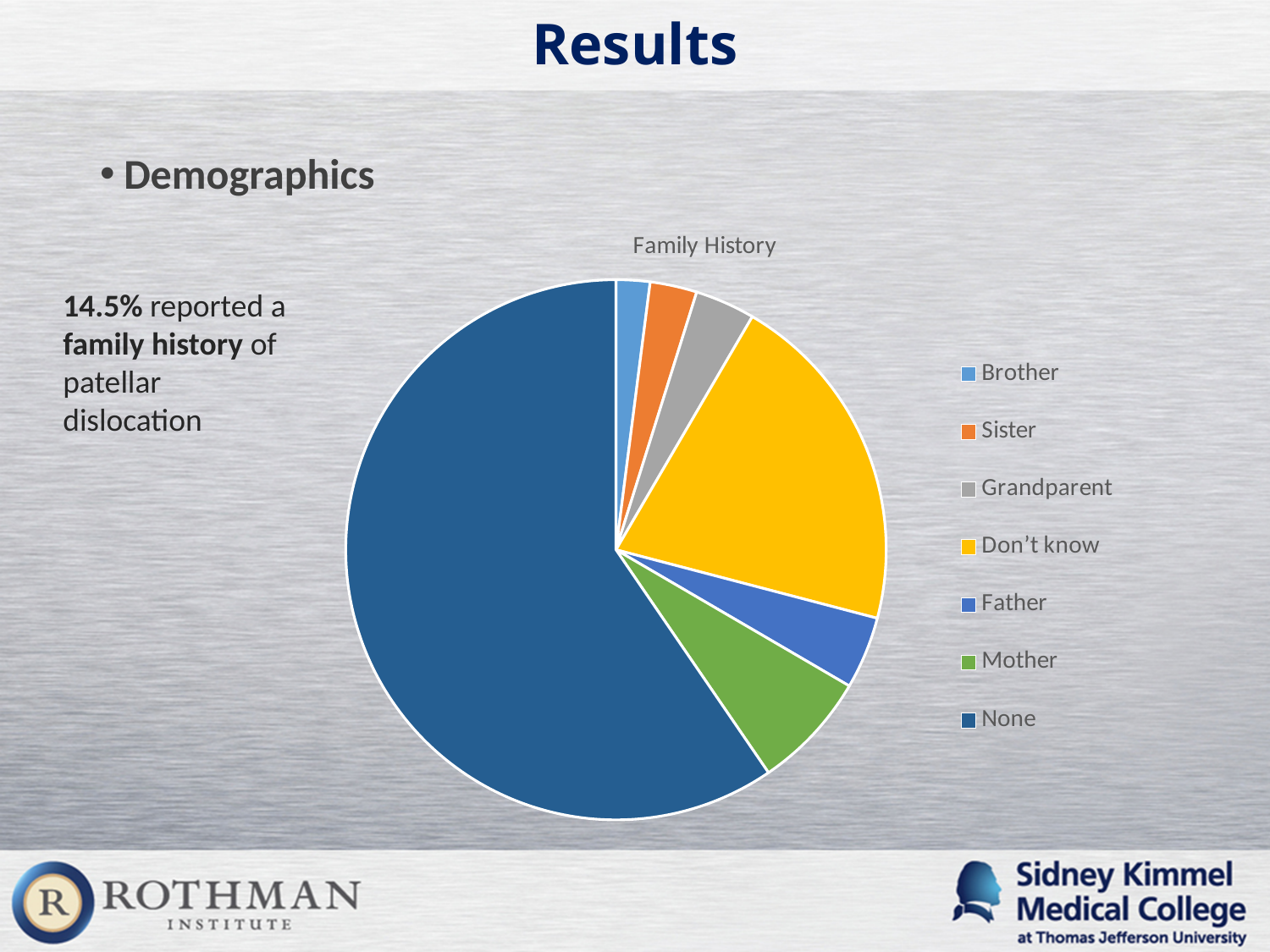
Which category is shown in yellow in the Family History pie chart? Don't know Which is larger in the Family History pie chart, the slice for Mother or the slice for Father? Mother Which is larger in the Family History pie chart, the slice for Father or the slice for Brother? Father Which is larger in the Family History pie chart, the slice for None or the slice for Don't know? None How many categories does the Family History pie chart have? 7 Which category has the largest slice in the Family History pie chart? None What kind of chart is shown on the slide? pie chart How many entries does the legend of the Family History chart list? 7 What is the title of the chart? Family History